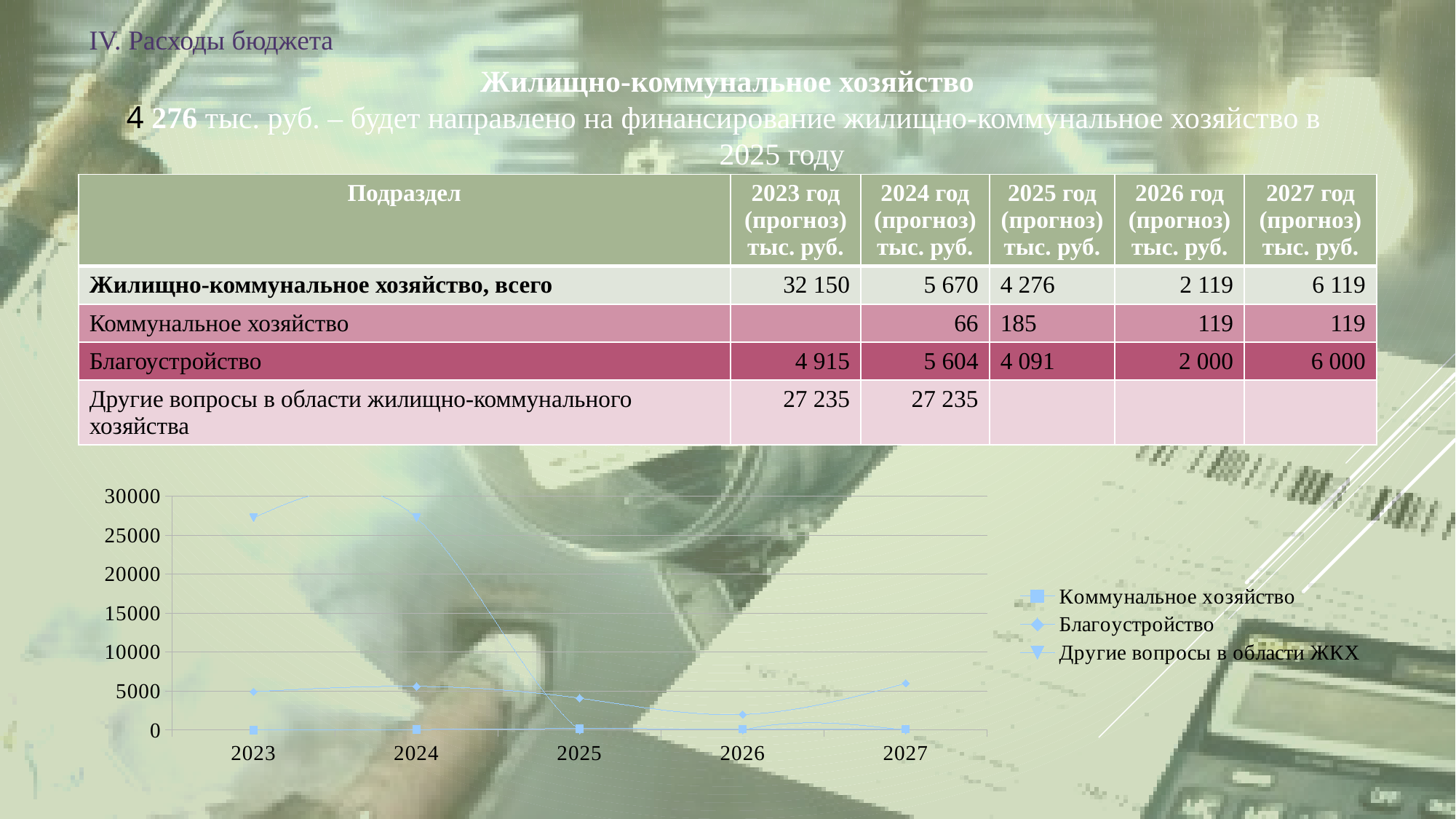
Which series are listed in the chart legend? Коммунальное хозяйство, Благоустройство, Другие вопросы в области ЖКХ How many years are shown along the x axis of the chart? 5 In 2025, which series has the larger value: Благоустройство or Коммунальное хозяйство? Благоустройство Is the value for Благоустройство in 2026 greater or less than 5000? less In 2023, which series has the larger value: Другие вопросы в области ЖКХ or Благоустройство? Другие вопросы в области ЖКХ In which year is the value for Благоустройство lowest? 2026 Is the value for Благоустройство in 2027 greater or less than 5000? greater What kind of chart is shown at the bottom of the slide? line chart How many series does the chart legend list? 3 Is the value for Другие вопросы в области ЖКХ in 2023 greater or less than 25000? greater Does the value for Другие вопросы в области ЖКХ rise or fall from 2024 to 2025? fall